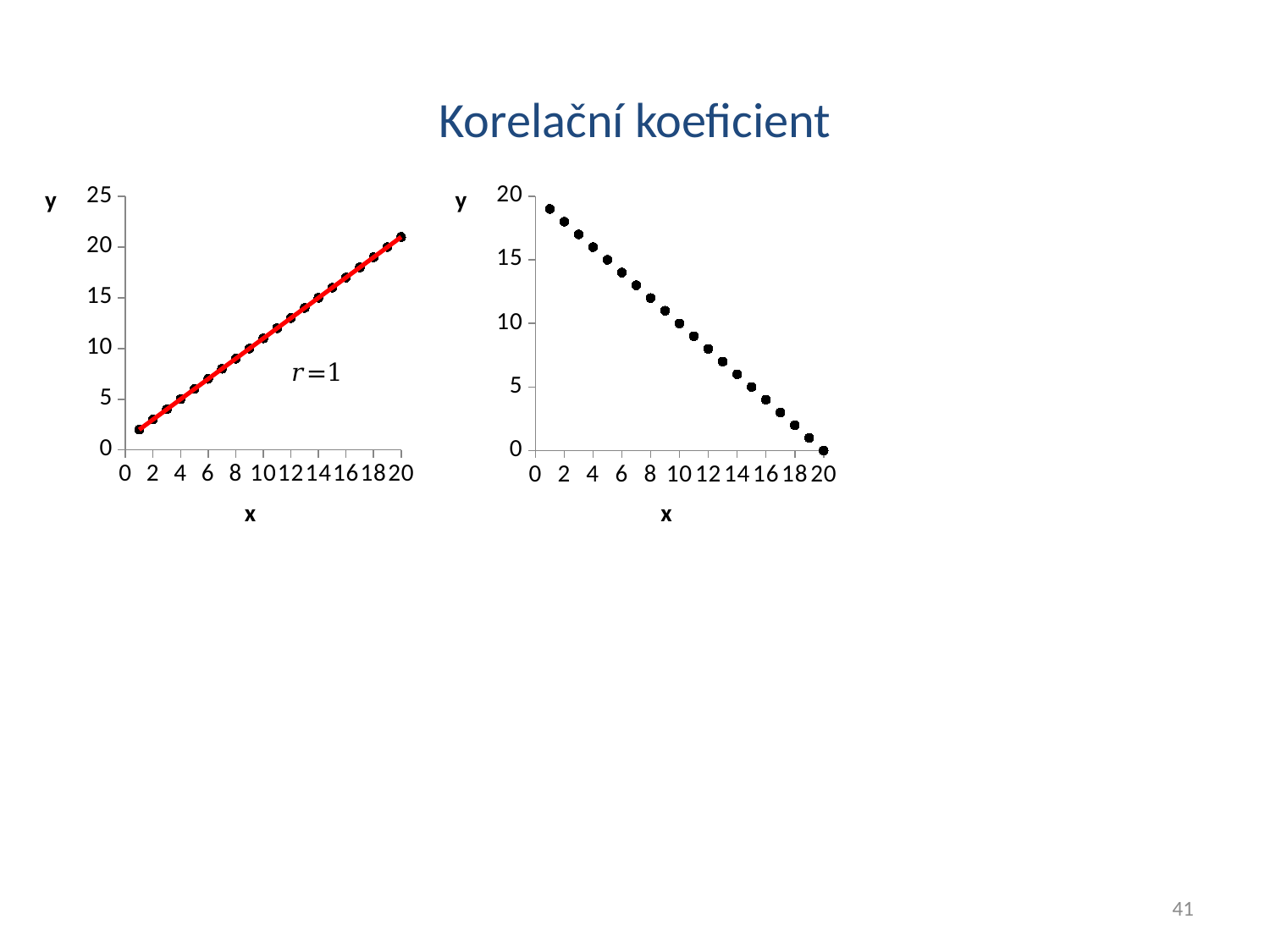
In the right chart, is the y value at x = 18 greater or less than 5? less In the right chart, what is the y value at x = 10? 10 In the left chart, is the y value at x = 6 greater or less than 5? greater In the right chart, do the y values rise or fall as x increases? fall What correlation coefficient value is annotated on the left chart? r = 1 What kind of chart is the left chart? scatter chart In the right chart, what is the y value at x = 20? 0 How many data points are plotted in the right chart? 20 What is the title of the slide containing the two charts? Korelační koeficient What kind of chart is the right chart? scatter chart In the left chart, do the y values rise or fall as x increases? rise How many data points are plotted in the left chart? 20